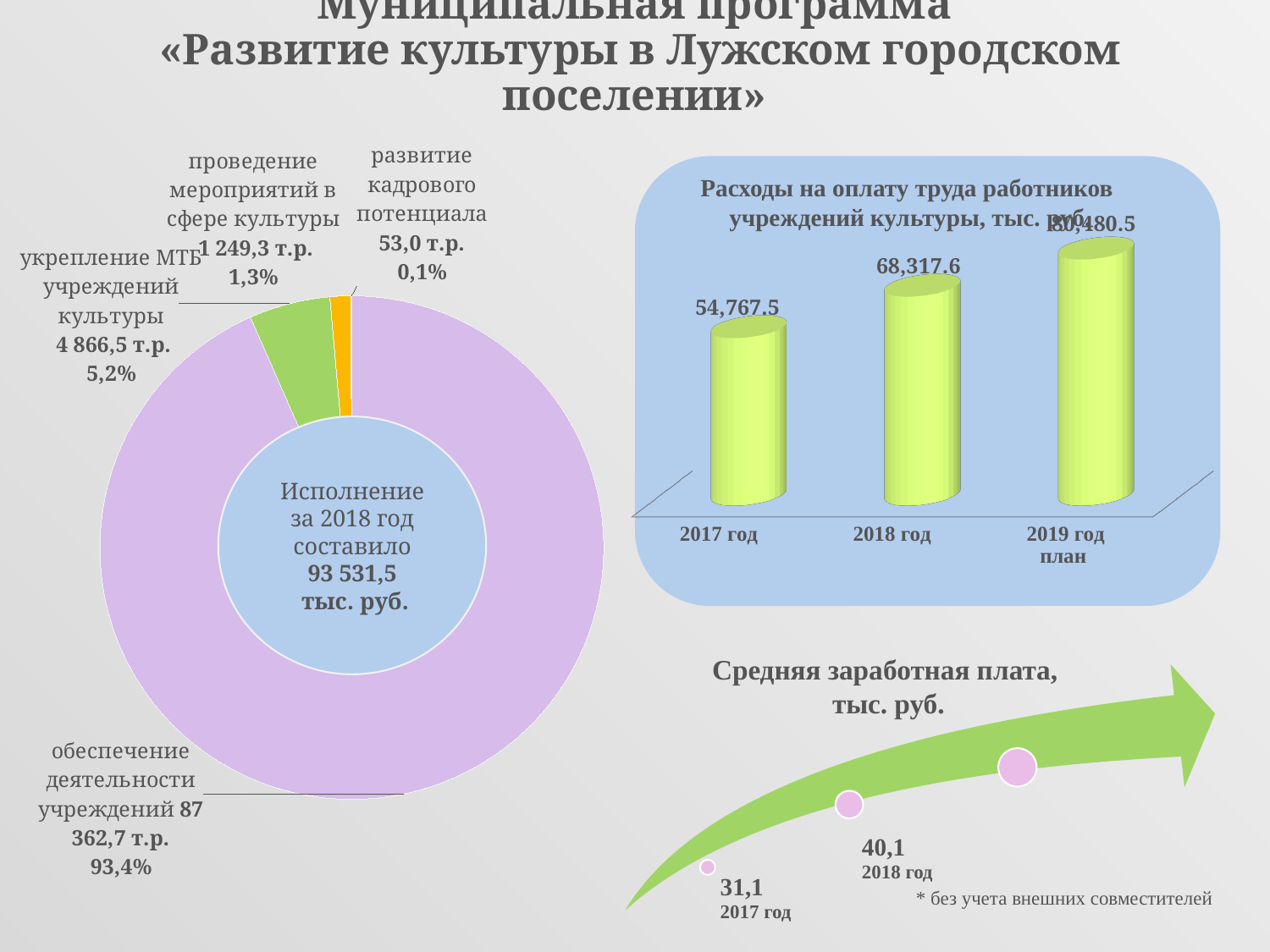
In the 'Расходы на оплату труда работников учреждений культуры' chart, what is the value for 2018 год? 68,317.6 In the doughnut chart on the left, what share does 'обеспечение деятельности учреждений' have? 93,4% In the 'Расходы на оплату труда работников учреждений культуры' chart, which year has the highest value? 2019 год план In the 'Расходы на оплату труда работников учреждений культуры' chart, do the values rise or fall from 2017 to 2019? rise In the 'Расходы на оплату труда работников учреждений культуры' chart, what is the value for 2017 год? 54,767.5 In the doughnut chart on the left, which is larger: 'укрепление МТБ учреждений культуры' or 'проведение мероприятий в сфере культуры'? укрепление МТБ учреждений культуры In the doughnut chart on the left, what is the value for 'укрепление МТБ учреждений культуры'? 4 866,5 т.р. How many categories are shown in the doughnut chart on the left? 4 How many bars are shown in the 'Расходы на оплату труда работников учреждений культуры' chart? 3 In the doughnut chart on the left, which category has the smallest share? развитие кадрового потенциала What type of chart is the 'Расходы на оплату труда работников учреждений культуры, тыс. руб.' chart? bar chart In the 'Расходы на оплату труда работников учреждений культуры' chart, what is the difference between the 2018 год and 2017 год values? 13,550.1